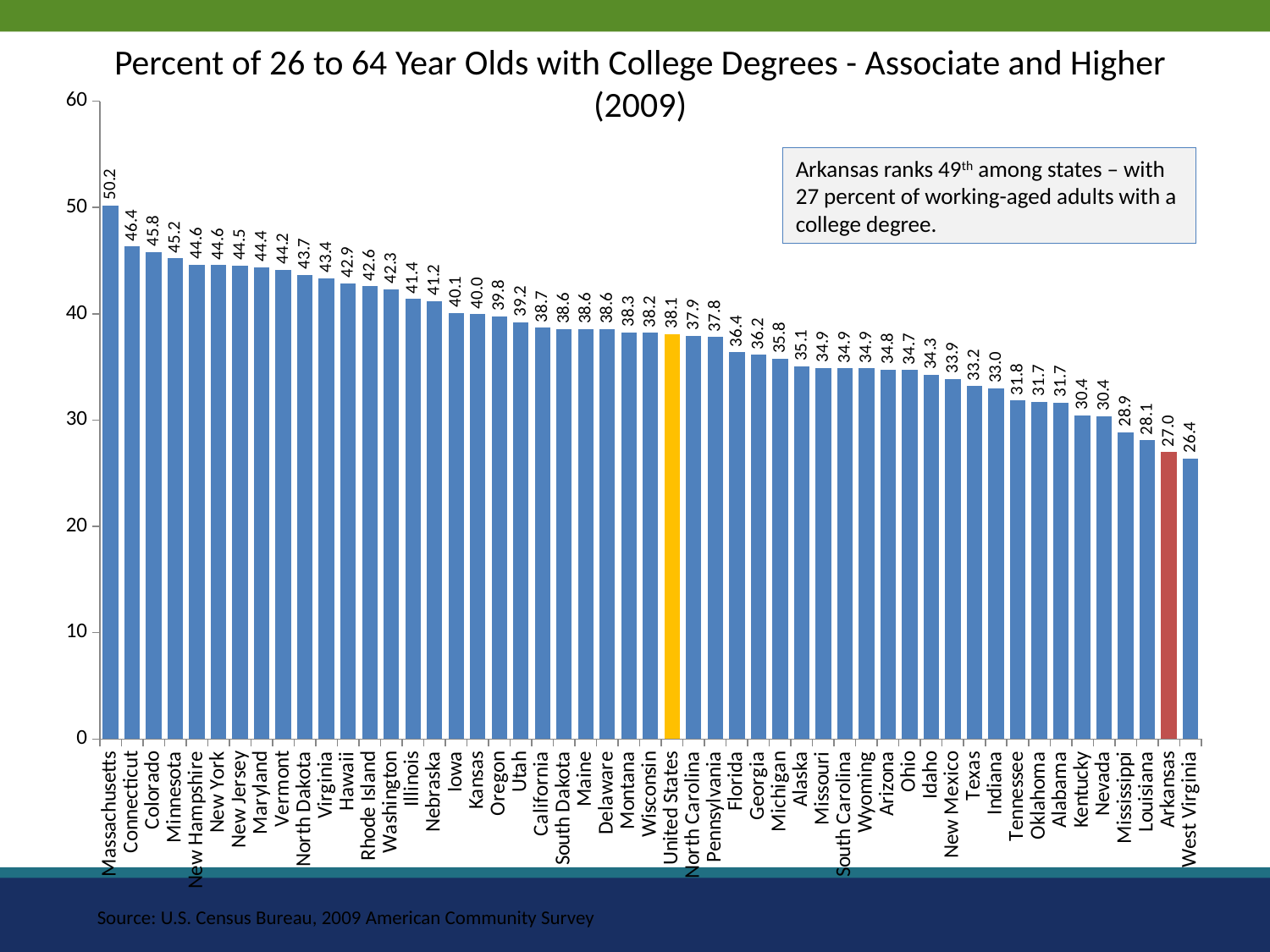
Which bar is highlighted in red? Arkansas What kind of chart is shown on the slide? bar chart What is the value for Texas? 33.2 How many bars are plotted on the chart? 51 What is the value for the United States bar? 38.1 Which category has the highest value? Massachusetts Is the value for Colorado greater or less than 40? greater What is the value for Massachusetts? 50.2 Which is larger, the value for Louisiana or the value for Mississippi? Mississippi What is the value for Arkansas? 27.0 What is the difference between the values for Massachusetts and Arkansas? 23.2 Which category has the lowest value? West Virginia